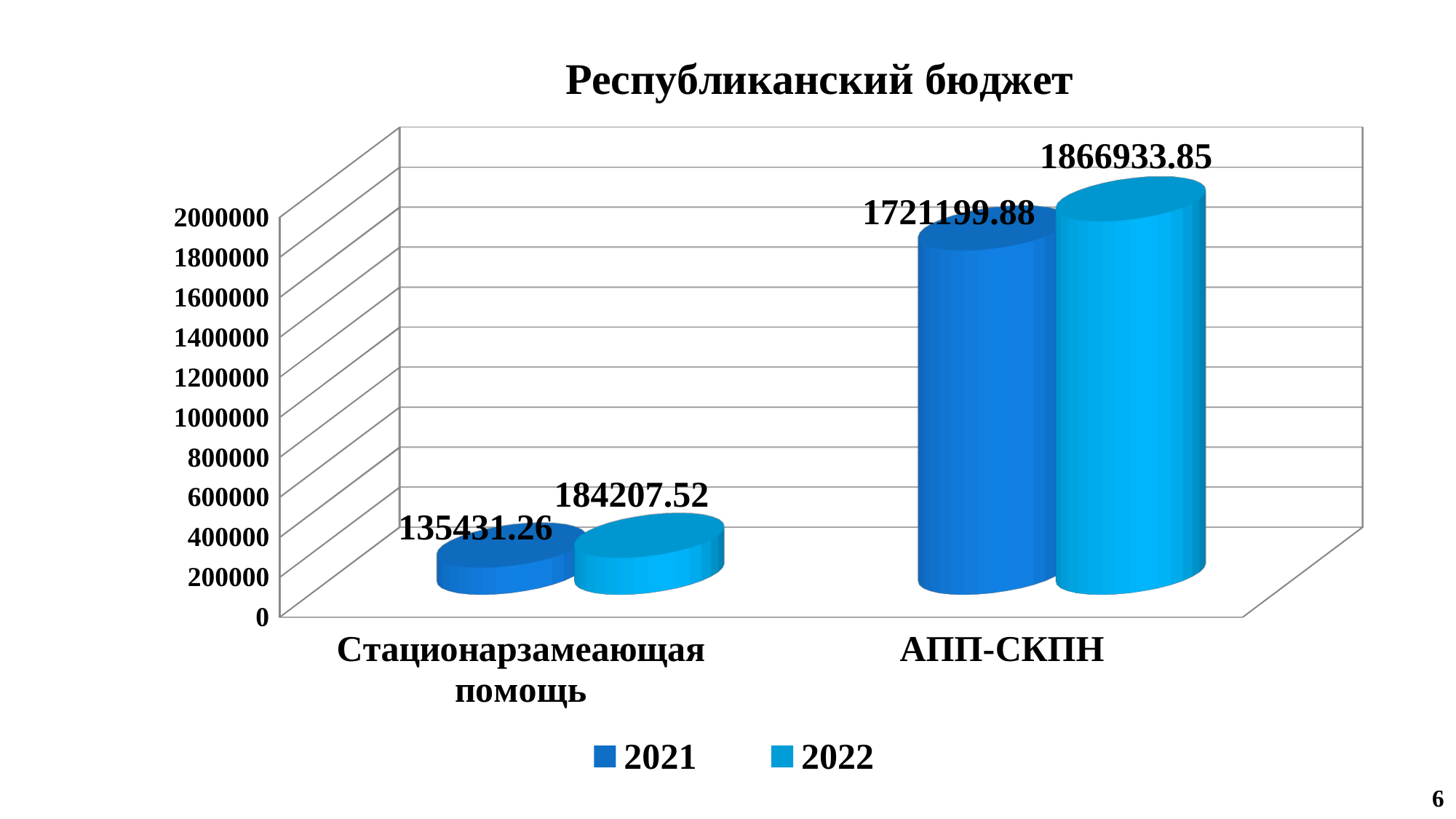
What is the difference between the 2022 and 2021 values for АПП-СКПН? 145733.97 Which category has the highest value in 2022? АПП-СКПН For АПП-СКПН, which year has the larger value, 2021 or 2022? 2022 What is the difference between the 2022 and 2021 values for Стационарзамеаающая помощь? 48776.26 What is the 2022 value for Стационарзамеаающая помощь? 184207.52 How many categories are shown on the x axis? 2 What is the title of the chart? Республиканский бюджет How many series does the legend list? 2 Which category has the lowest value in 2021? Стационарзамеающая помощь What is the 2021 value for АПП-СКПН? 1721199.88 What is the 2021 value for Стационарзамеаающая помощь? 135431.26 What is the 2022 value for АПП-СКПН? 1866933.85